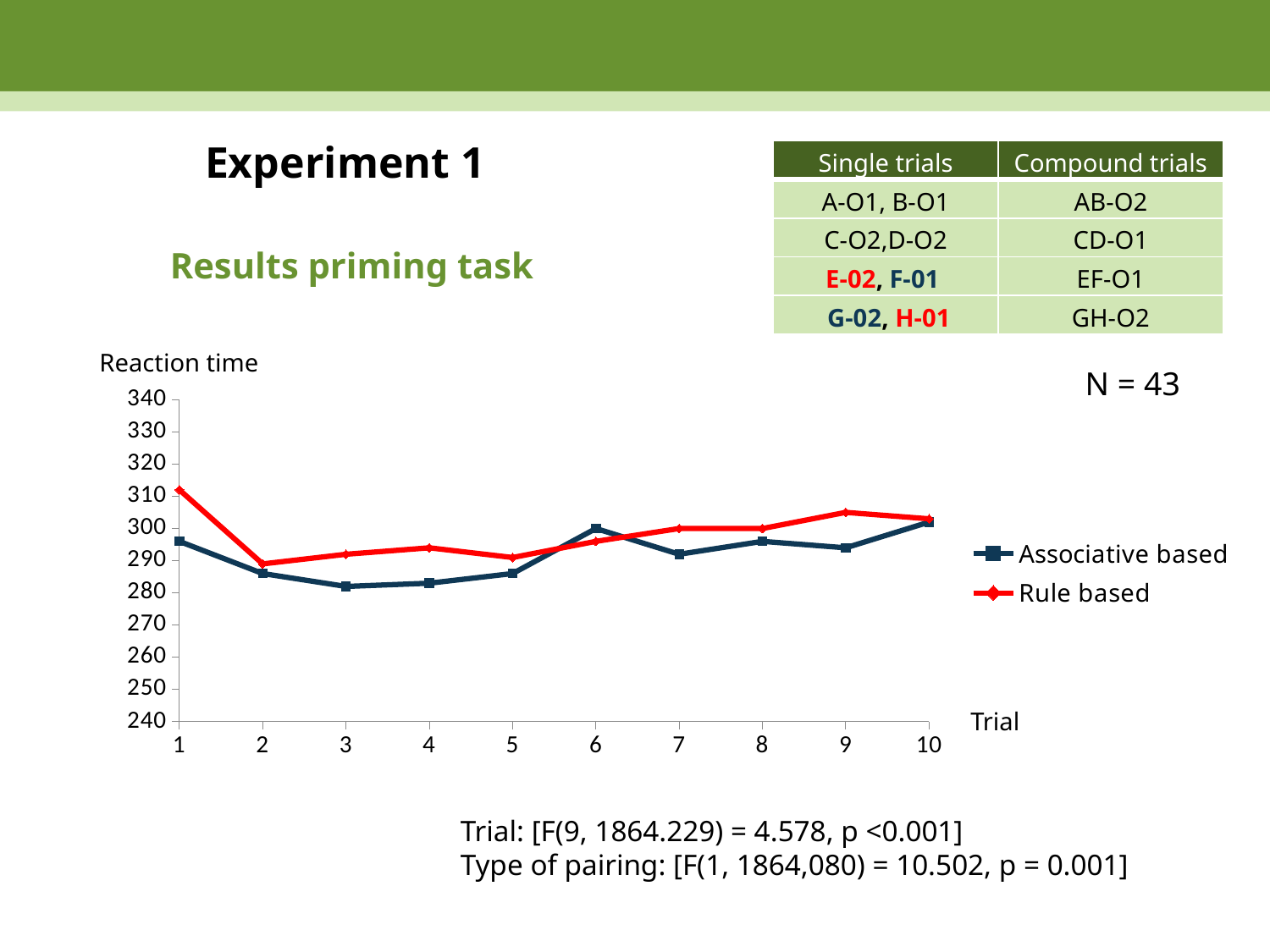
Is the Associative based value at trial 1 greater or less than 300? less At trial 1, which series has the higher reaction time, Associative based or Rule based? Rule based Is the Rule based value at trial 9 greater or less than 300? greater Is the Associative based value at trial 3 greater or less than 290? less What is the label on the y axis of the chart? Reaction time Does the Associative based line rise or fall from trial 1 to trial 3? fall At which trial is the Rule based reaction time highest? 1 How many trials are plotted along the x axis? 10 How many series does the chart legend list? 2 At trial 4, which series has the higher reaction time, Associative based or Rule based? Rule based What kind of chart is shown on the slide? line chart